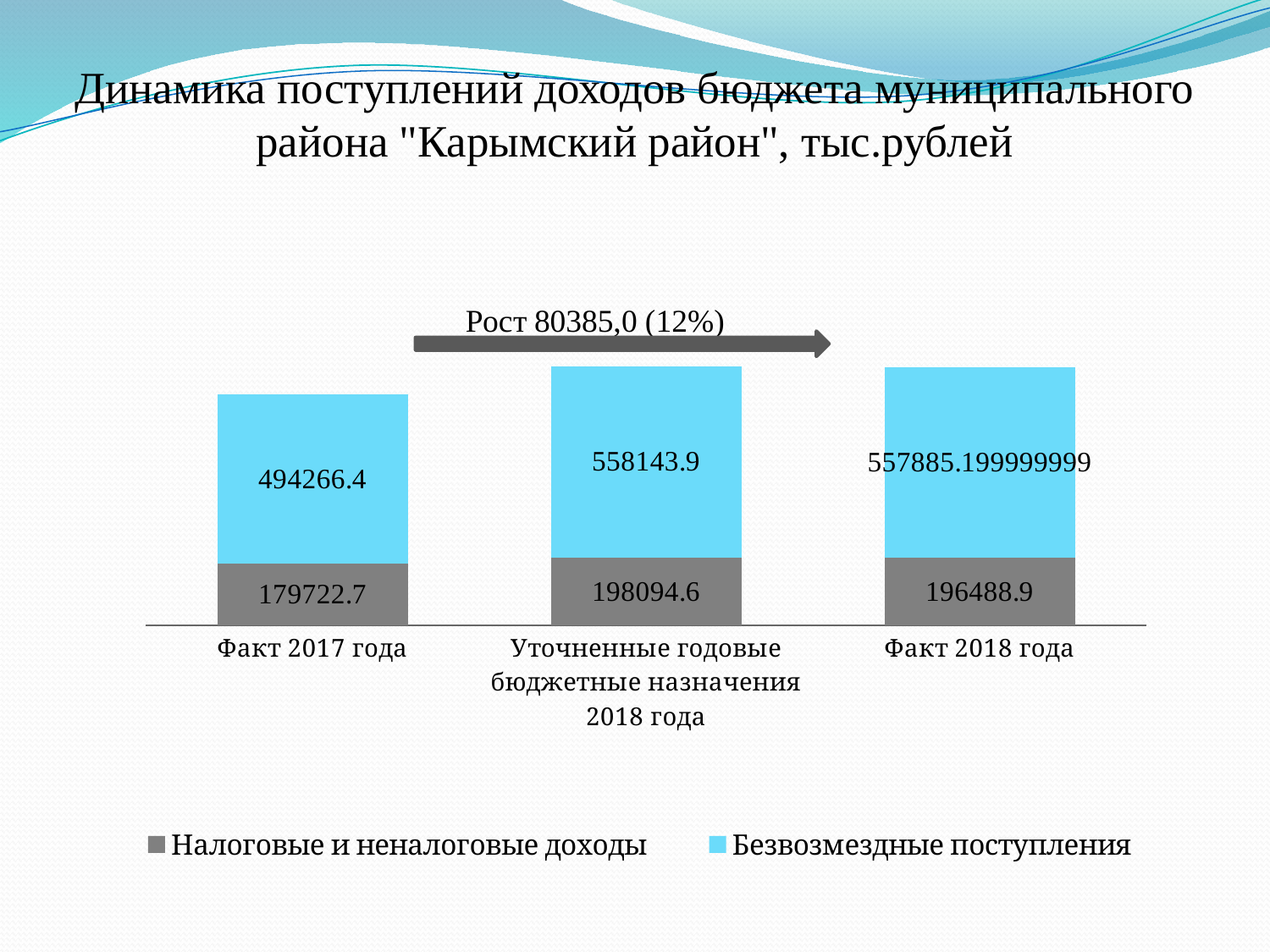
What is the value of Безвозмездные поступления for Уточненные годовые бюджетные назначения 2018 года? 558143.9 What is the value of Налоговые и неналоговые доходы for Факт 2018 года? 196488.9 Which category has the lowest value for Налоговые и неналоговые доходы? Факт 2017 года Which is larger: Безвозмездные поступления for Факт 2017 года or for Факт 2018 года? Факт 2018 года What is the difference in Безвозмездные поступления between Уточненные годовые бюджетные назначения 2018 года and Факт 2017 года? 63877.5 How many categories are shown on the x axis? 3 What is the value of Налоговые и неналоговые доходы for Факт 2017 года? 179722.7 What is the difference in Налоговые и неналоговые доходы between Уточненные годовые бюджетные назначения 2018 года and Факт 2017 года? 18371.9 How many series does the legend list? 2 What is the total of the stacked bar for Факт 2017 года? 673989.1 What is the value of Безвозмездные поступления for Факт 2017 года? 494266.4 Which category has the highest value for Безвозмездные поступления? Уточненные годовые бюджетные назначения 2018 года